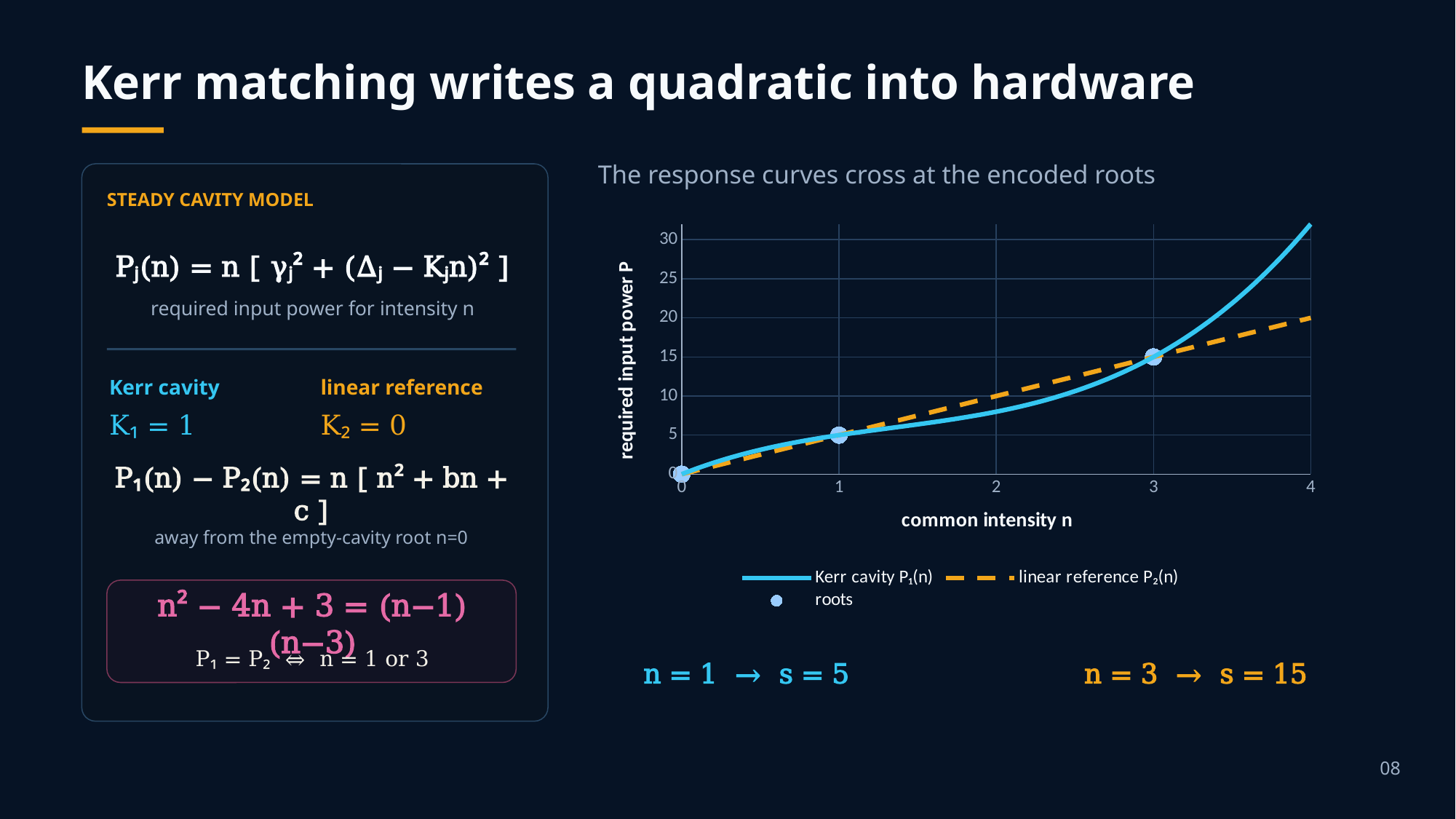
At n = 4, which curve is higher, the Kerr cavity P₁(n) or the linear reference P₂(n)? Kerr cavity P₁(n) According to the slide, what is the required input power s at the root n = 3? 15 What kind of chart is shown on the slide? line chart How many entries does the chart legend list? 3 What is the difference between the required input power at n = 3 and at n = 1? 10 What is the title of the chart's x axis? common intensity n Does the Kerr cavity P₁(n) curve rise or fall as n increases? rises Is the value of the linear reference P₂(n) at n = 4 greater or less than 25? less Is the value of the Kerr cavity P₁(n) at n = 2 greater or less than 10? less At n = 2, which curve is higher, the Kerr cavity P₁(n) or the linear reference P₂(n)? linear reference P₂(n) How many root markers are plotted on the chart? 3 According to the slide, what is the required input power s at the root n = 1? 5